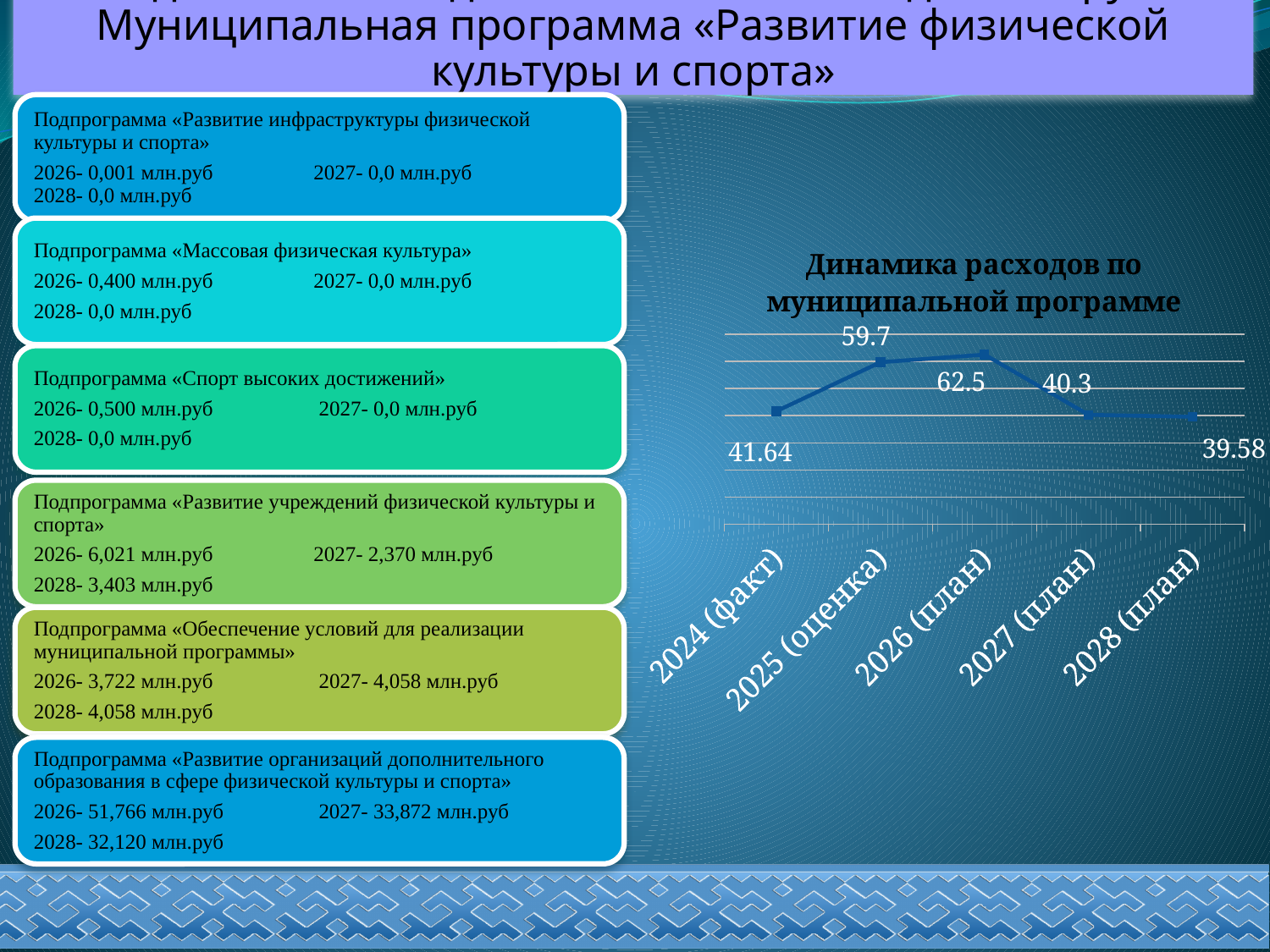
What is the value for 2026 (план) in the chart? 62.5 What is the difference between the values for 2026 (план) and 2027 (план)? 22.2 How many categories are plotted on the x axis of the chart? 5 What is the value for 2028 (план) in the chart? 39.58 Which category has the lowest value in the chart? 2028 (план) Which category has the highest value in the chart? 2026 (план) What is the value for 2025 (оценка) in the chart? 59.7 Which is larger, the value for 2025 (оценка) or the value for 2027 (план)? 2025 (оценка) What is the value for 2024 (факт) in the chart 'Динамика расходов по муниципальной программе'? 41.64 What is the title of the chart on the slide? Динамика расходов по муниципальной программе What is the difference between the values for 2025 (оценка) and 2024 (факт)? 18.06 What kind of chart is shown on the slide? line chart